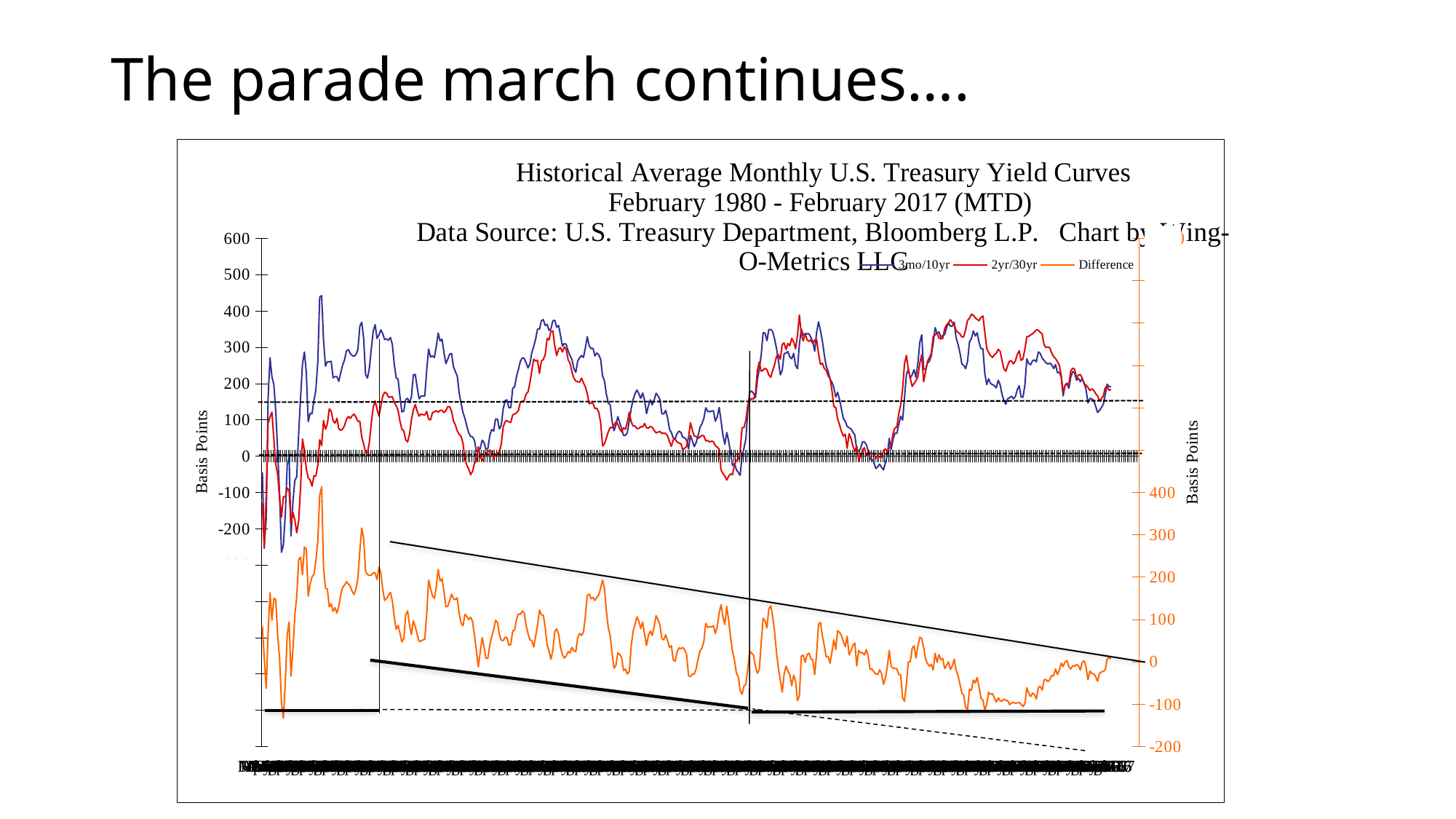
Does the Difference series generally rise or fall from left to right across the period? fall Is the highest value reached by the 3mo/10yr series greater or less than 400? greater Which series is drawn in orange? Difference What kind of chart is shown on the slide? line chart Is the highest value reached by the 2yr/30yr series greater or less than 300? greater How many series does the legend list? 3 Is the highest value of the Difference series, read on the right axis, greater or less than 300? greater Which series reaches a higher peak, 3mo/10yr or 2yr/30yr? 3mo/10yr What data sources are named in the chart title? U.S. Treasury Department, Bloomberg L.P.